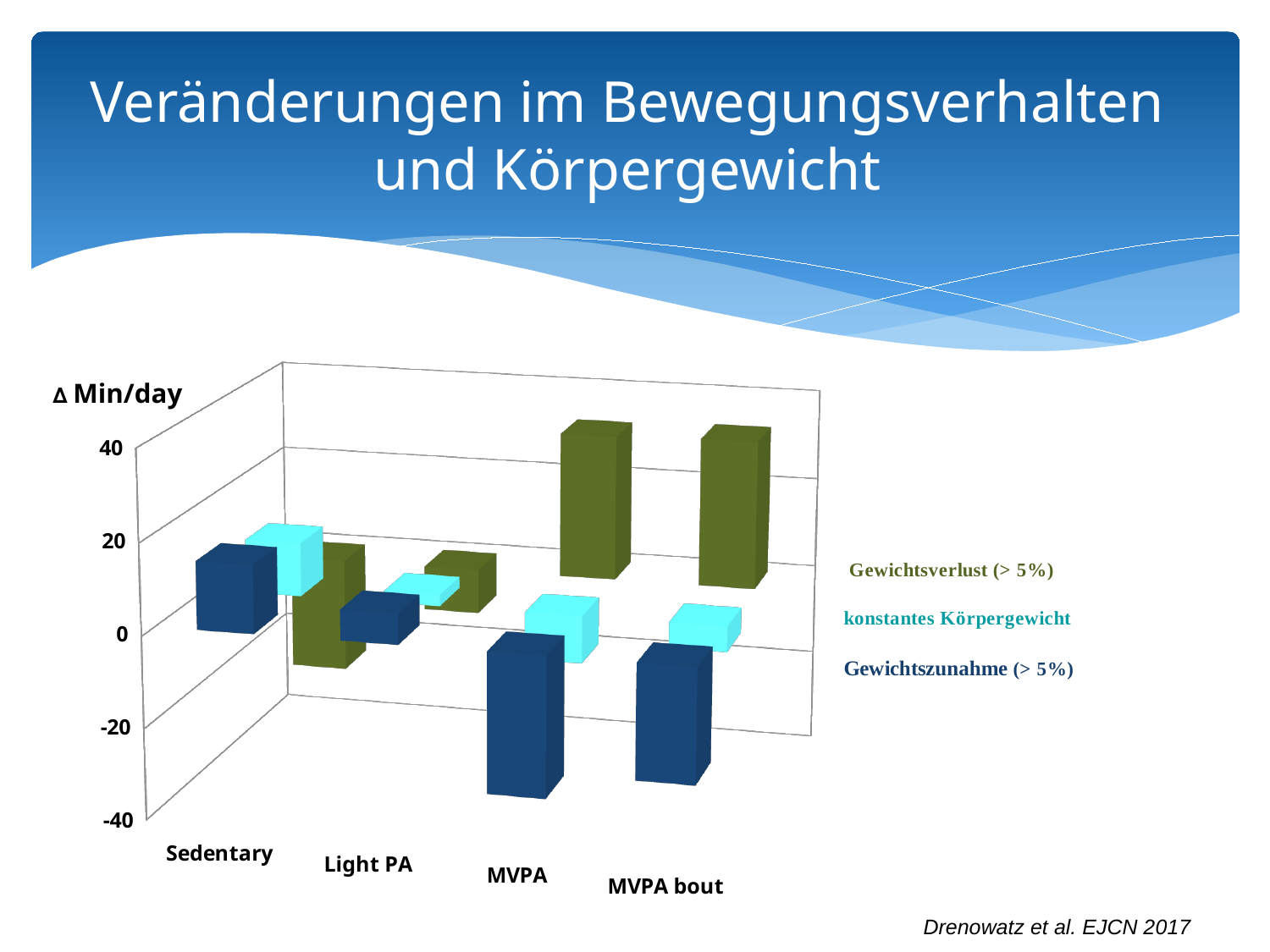
Is the value for 'Gewichtsverlust (> 5%)' in the Sedentary category greater or less than 0? less For 'Gewichtsverlust (> 5%)', which is larger: the value for MVPA or the value for Sedentary? MVPA What kind of chart is shown on the slide? bar chart Is the value for 'Gewichtszunahme (> 5%)' in the MVPA category greater or less than -20? less How many activity categories are shown on the x axis of the chart? 4 Is the value for 'Gewichtszunahme (> 5%)' in the Sedentary category greater or less than 0? greater What is the label on the vertical axis of the chart? Δ Min/day How many series does the chart's legend list? 3 In the MVPA category, which series has the highest value? Gewichtsverlust (> 5%) Which colour represents the series 'konstantes Körpergewicht' in the chart? cyan For 'Gewichtszunahme (> 5%)', which is larger: the value for Sedentary or the value for MVPA? Sedentary